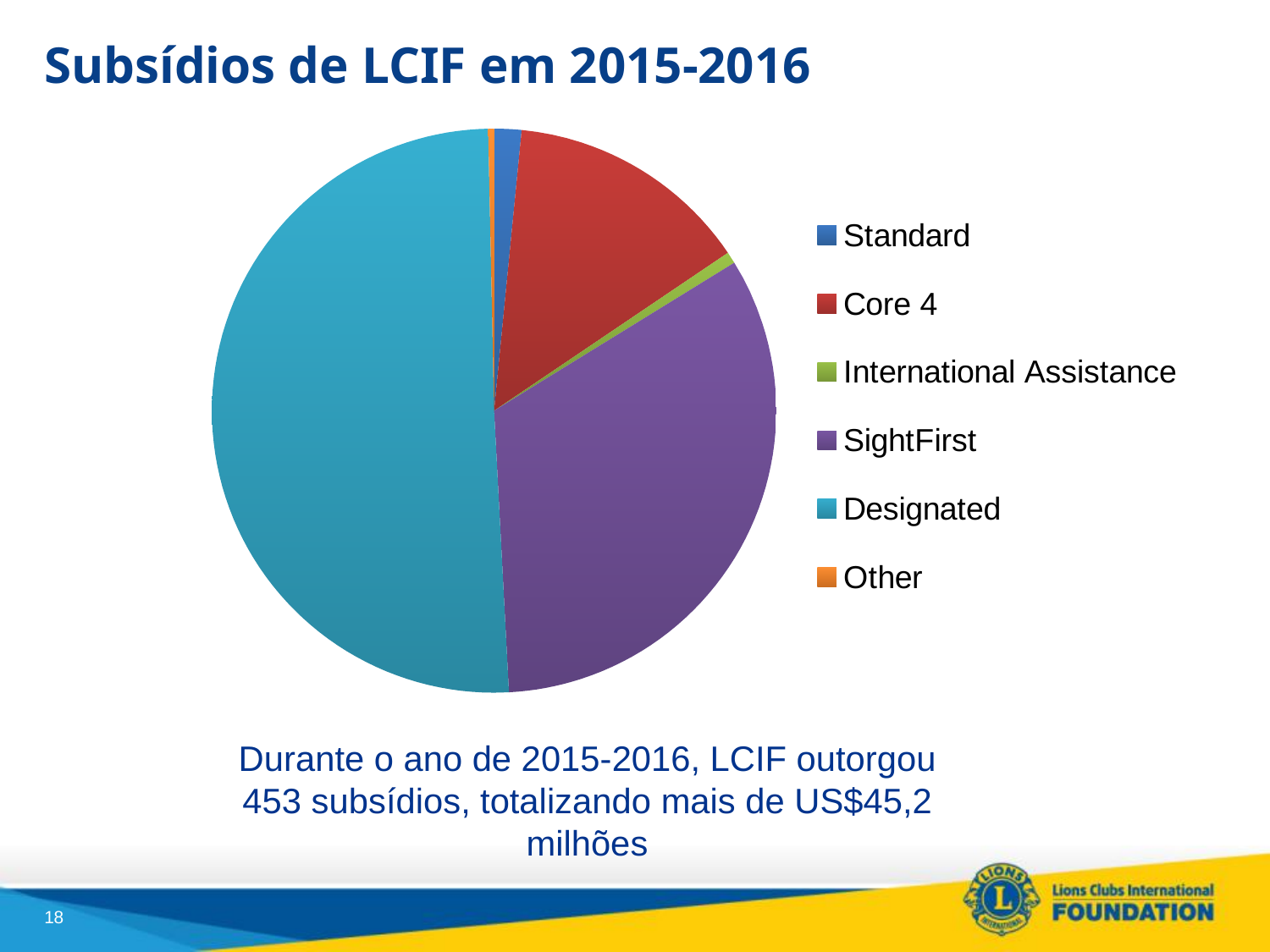
Which category is the second largest slice of the pie chart? SightFirst How many categories does the legend of the pie chart list? 6 Which category has the largest slice of the pie chart? Designated Which legend entry is listed last in the pie chart's legend? Other Which slice is larger, SightFirst or Core 4? SightFirst Which slice is larger, Designated or SightFirst? Designated Which slice is larger, Core 4 or Standard? Core 4 What is the title of the slide containing the pie chart? Subsídios de LCIF em 2015-2016 What kind of chart is shown on the slide? Pie chart What colour is the Designated slice in the pie chart? Teal How many slices does the pie chart have? 6